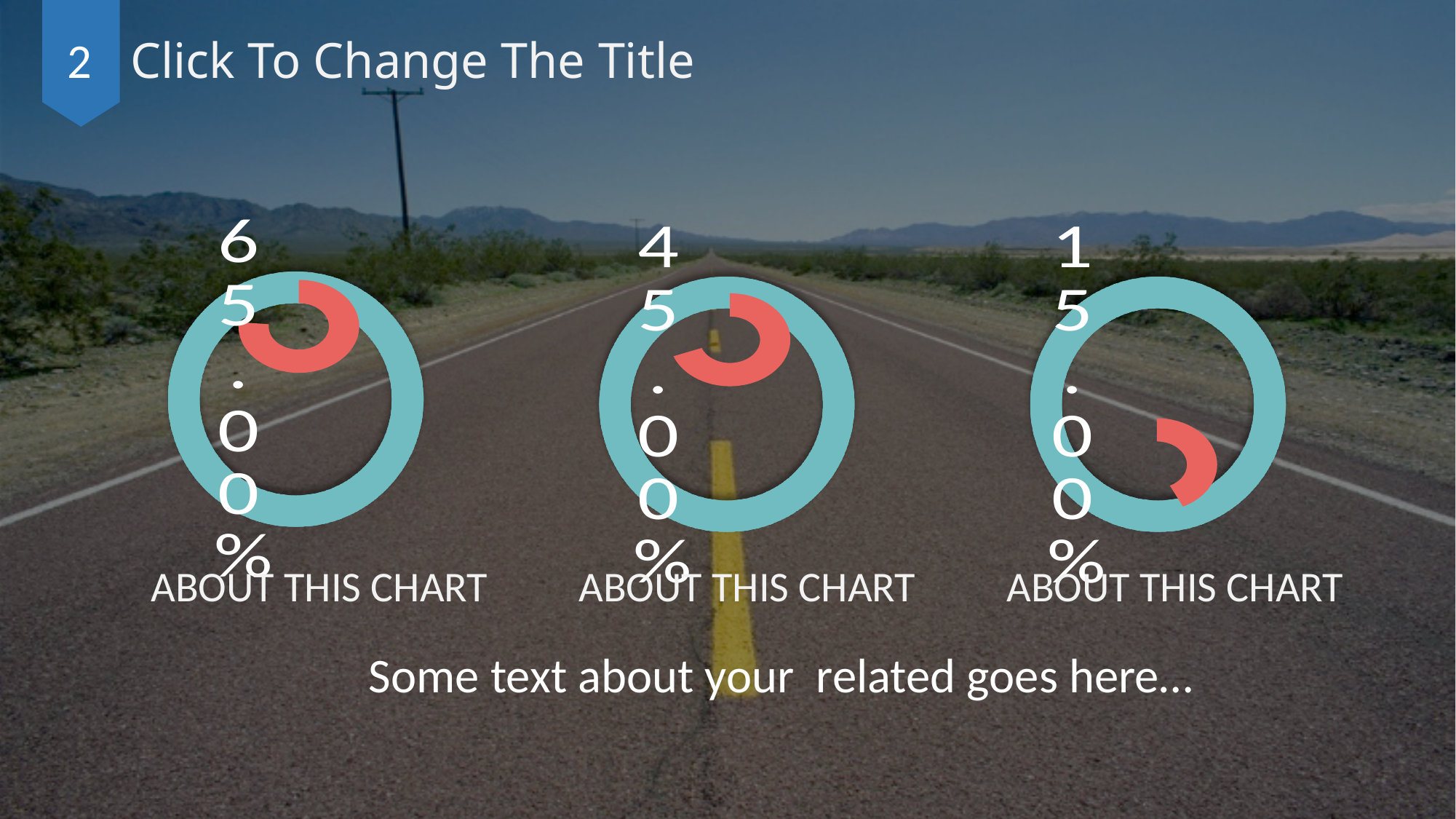
What is the difference between the value on the middle chart and the value on the right chart? 30.00% How many charts are shown on the slide? 3 What value is printed on the middle chart? 45.00% What value is printed on the left chart? 65.00% Which of the three charts shows the highest printed value? The left chart (65.00%) What value is printed on the right chart? 15.00% What colour is the outer ring of each chart? Teal Which is larger, the value on the middle chart or the value on the right chart? The middle chart (45.00%) Which of the three charts shows the lowest printed value? The right chart (15.00%) What is the difference between the value on the left chart and the value on the middle chart? 20.00% What caption appears below each of the three charts? ABOUT THIS CHART What kind of chart is used for each of the three figures on the slide? Donut chart